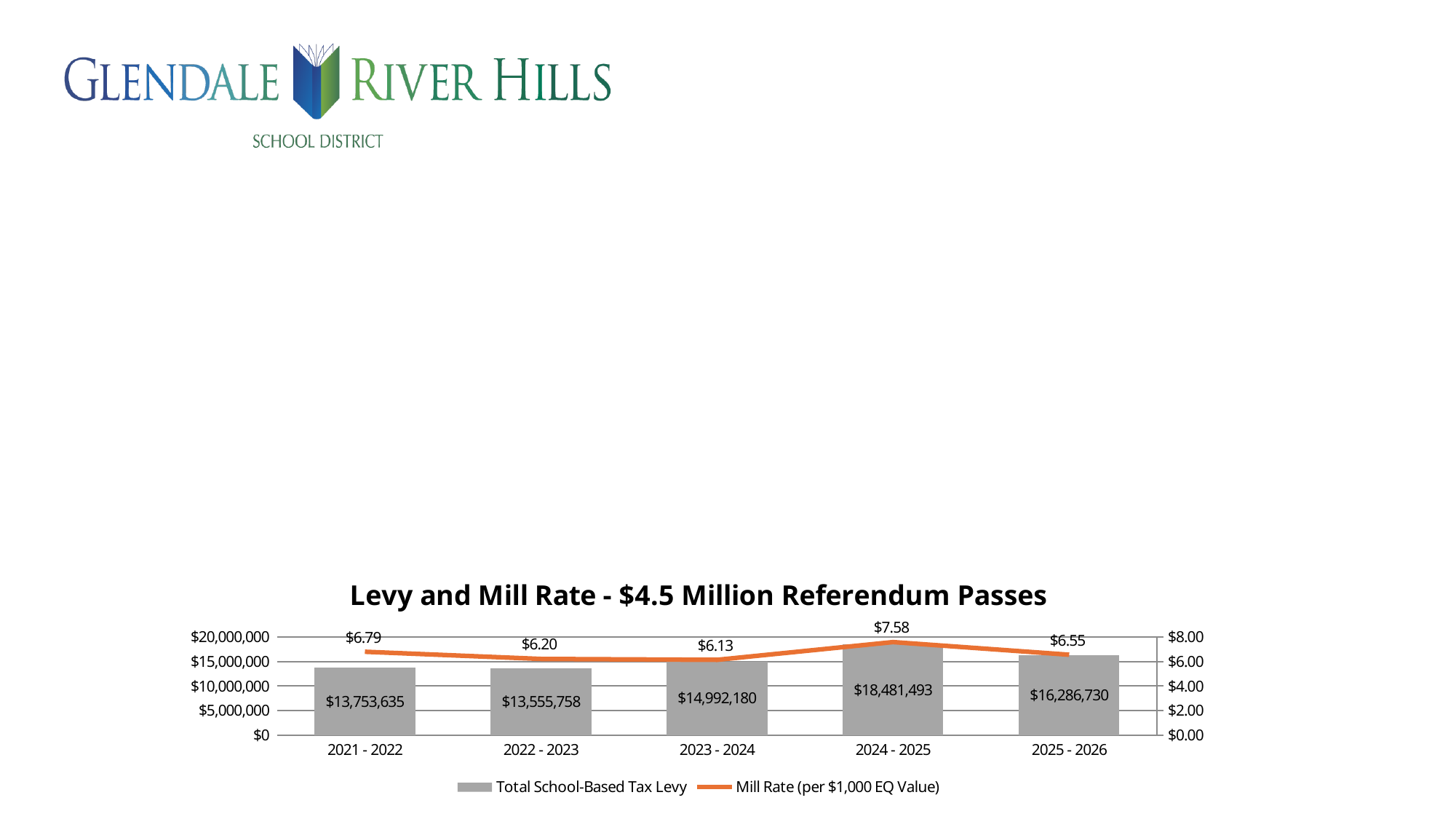
Which is larger, the Mill Rate for 2022 - 2023 or for 2025 - 2026? 2025 - 2026 What is the Total School-Based Tax Levy for 2022 - 2023? $13,555,758 Which year has the highest Total School-Based Tax Levy? 2024 - 2025 What kind of chart is used to show the Total School-Based Tax Levy? Bar chart Is the Total School-Based Tax Levy for 2023 - 2024 greater or less than $10,000,000? greater How many school years are shown on the x axis? 5 What is the difference between the Total School-Based Tax Levy for 2024 - 2025 and 2025 - 2026? $2,194,763 What is the Mill Rate (per $1,000 EQ Value) for 2021 - 2022? $6.79 How many series does the legend list? 2 What is the title of the chart? Levy and Mill Rate - $4.5 Million Referendum Passes Which year has the lowest Mill Rate (per $1,000 EQ Value)? 2023 - 2024 What is the Total School-Based Tax Levy for 2024 - 2025? $18,481,493